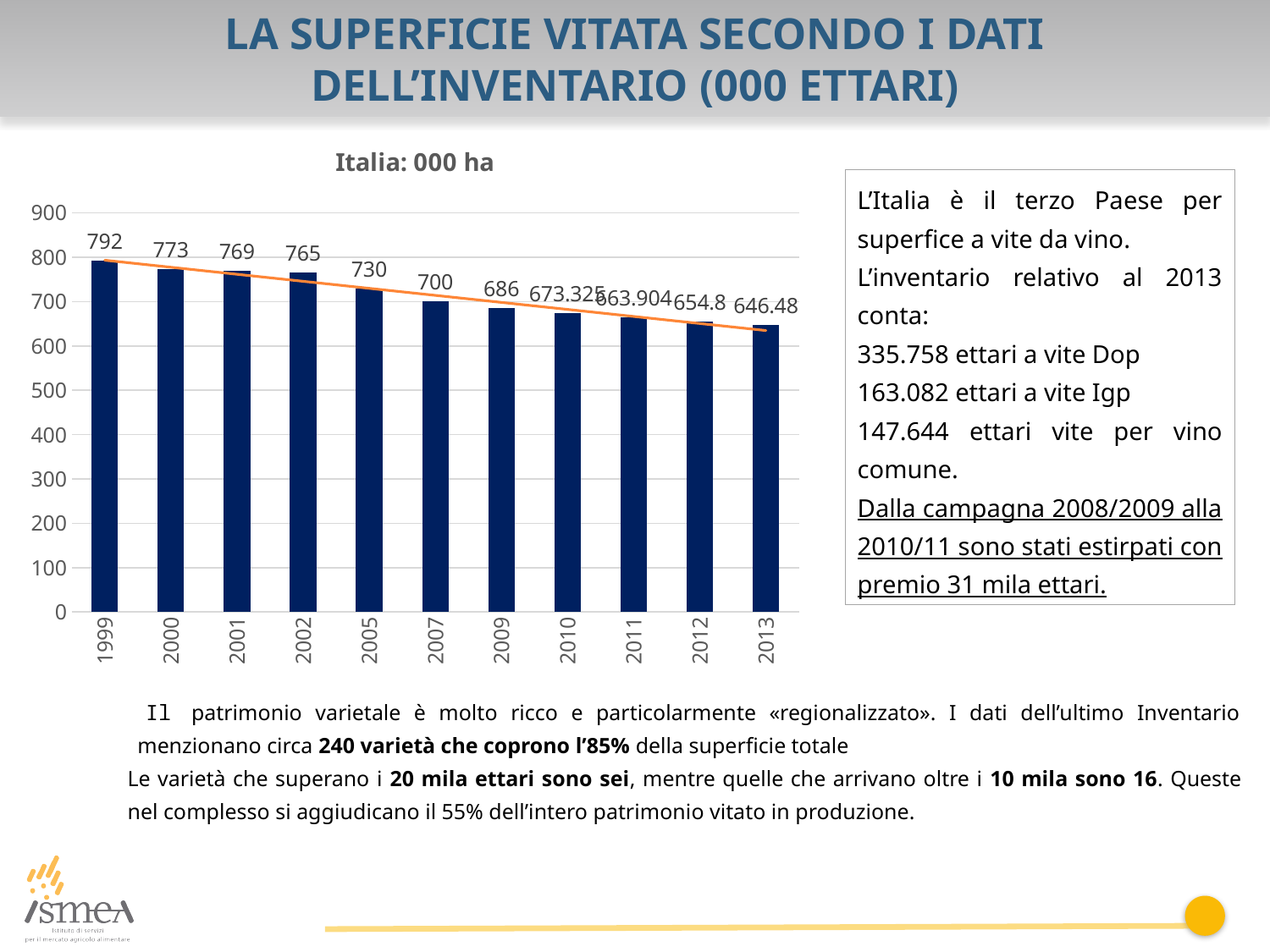
What is the difference between the values for 1999 and 2013? 145.52 Do the values rise or fall from 1999 to 2013? fall How many years are shown on the x axis? 11 Is the value for 2012 greater or less than 700? less What is the value for 1999? 792 Which year has the highest value? 1999 What is the value for 2005? 730 Which is larger, the value for 2002 or the value for 2007? 2002 Which year has the lowest value? 2013 What kind of chart is this? bar chart What is the difference between the values for 2000 and 2001? 4 What is the value for 2013? 646.48